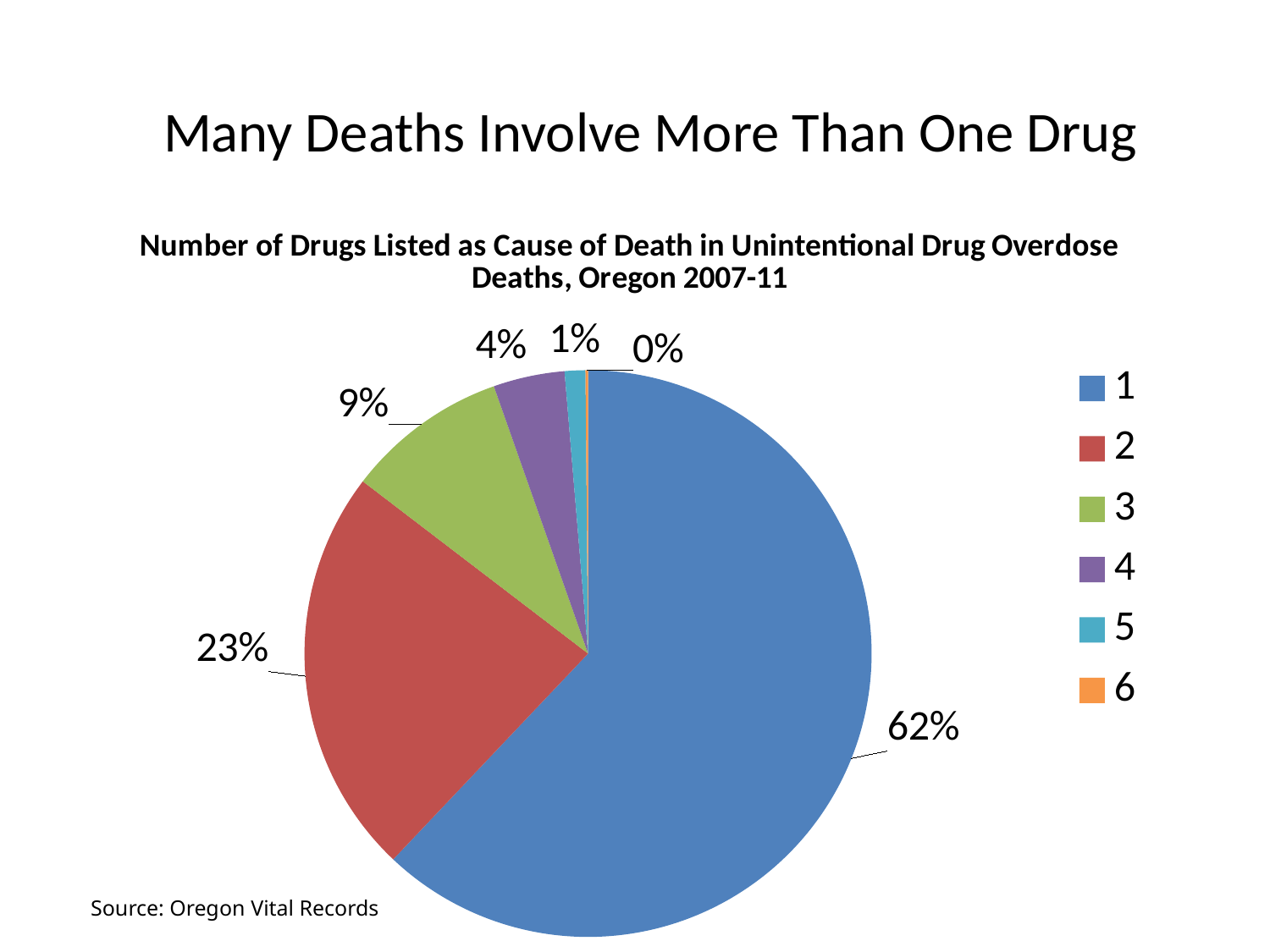
Which slice is larger, the one for 3 drugs or the one for 4 drugs? 3 What share of the pie is for 4 drugs listed as cause of death? 4% What share of the pie is for 3 drugs listed as cause of death? 9% Which category has the largest slice of the pie? 1 What share of the pie is for 2 drugs listed as cause of death? 23% What is the title of the chart? Number of Drugs Listed as Cause of Death in Unintentional Drug Overdose Deaths, Oregon 2007-11 Which category has the smallest slice of the pie? 6 What is the difference in percentage points between the slices for 1 drug and 2 drugs? 39 What kind of chart is shown on the slide? Pie chart How many categories does the legend list? 6